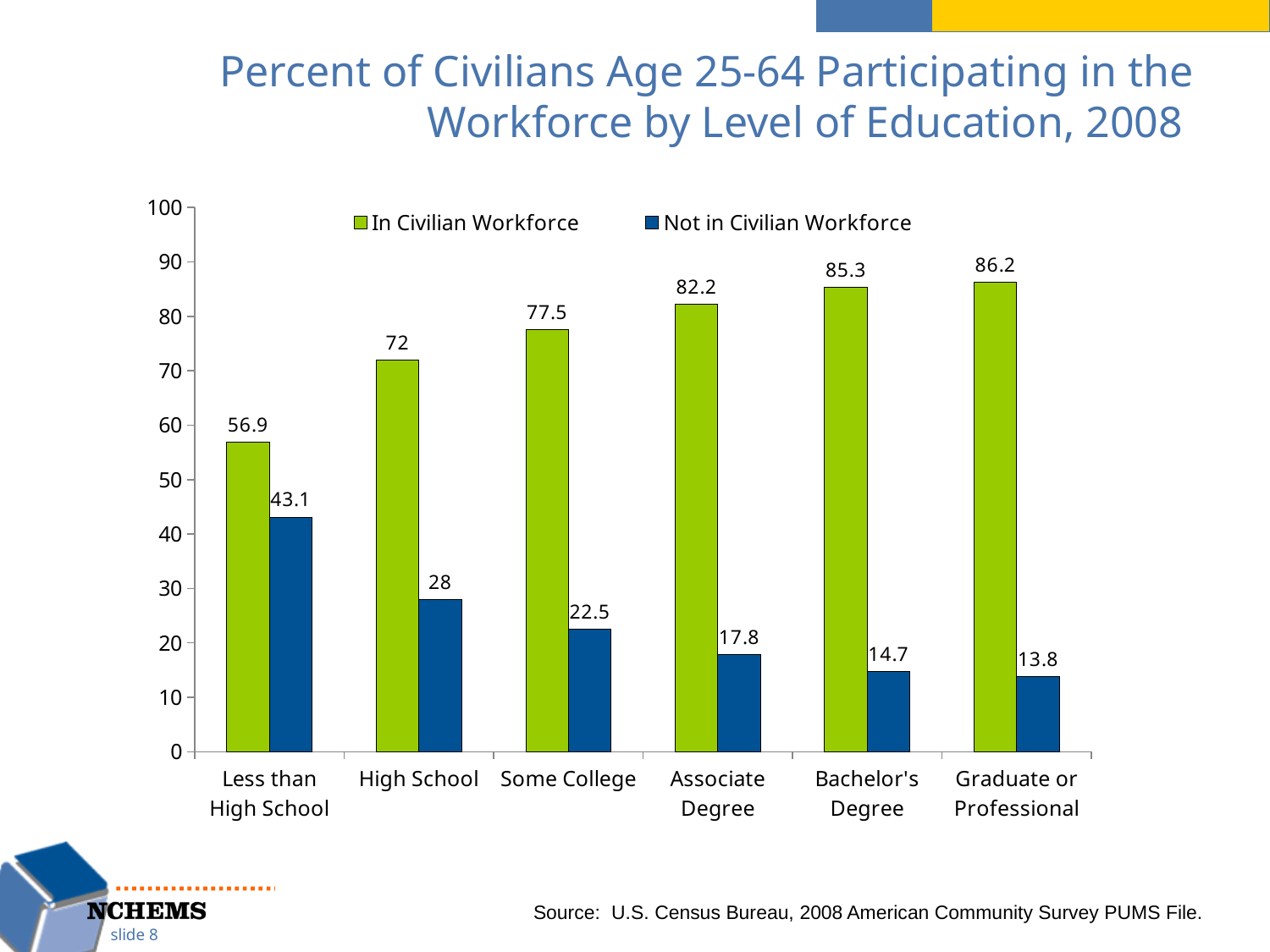
Do the In Civilian Workforce values rise or fall from Less than High School to Graduate or Professional? Rise How many education levels are shown on the x axis? 6 What is the value for Not in Civilian Workforce for Associate Degree? 17.8 What kind of chart is shown on the slide? Bar chart Which education level has the highest In Civilian Workforce value? Graduate or Professional Which education level has the lowest Not in Civilian Workforce value? Graduate or Professional What is the difference between the In Civilian Workforce values for Bachelor's Degree and High School? 13.3 What is the value for In Civilian Workforce for Less than High School? 56.9 Which is larger: the Not in Civilian Workforce value for High School or for Some College? High School Is the In Civilian Workforce value for Associate Degree greater or less than 80? greater What is the value for In Civilian Workforce for Some College? 77.5 How many series does the legend list? 2